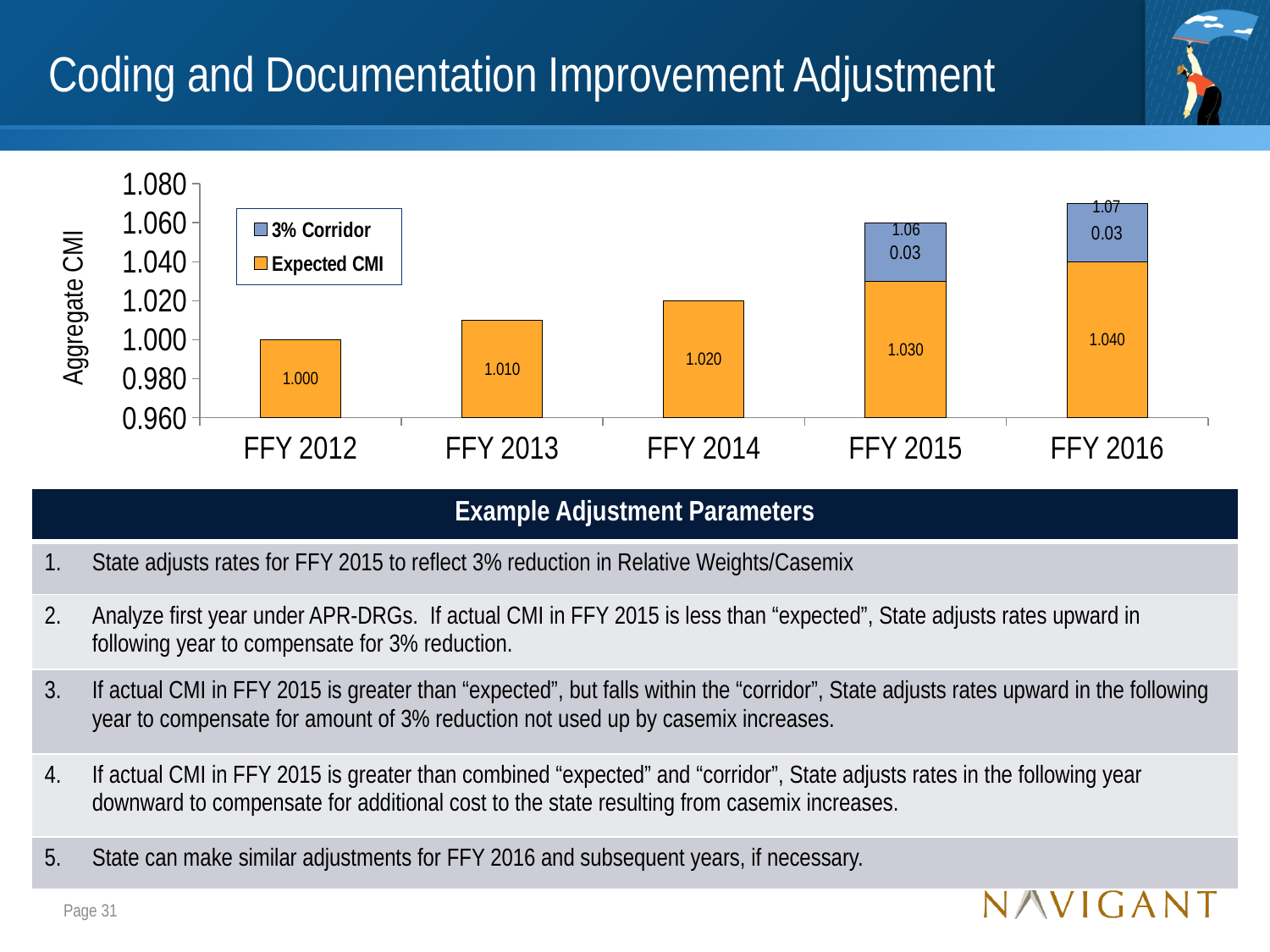
How many years are shown on the x axis of the chart? 5 Which is larger, the Expected CMI for FFY 2013 or for FFY 2015? FFY 2015 What is the 3% Corridor value for FFY 2015? 0.03 Do the Expected CMI values rise or fall from FFY 2012 to FFY 2016? Rise What is the total stacked value shown for FFY 2015? 1.06 What is the Expected CMI value for FFY 2016? 1.040 Which year has the lowest Expected CMI value? FFY 2012 What kind of chart is shown on the slide? Stacked bar chart What is the difference between the Expected CMI values for FFY 2016 and FFY 2012? 0.040 What is the Expected CMI value for FFY 2014? 1.020 Which year has the highest Expected CMI value? FFY 2016 How many series does the chart legend list? 2